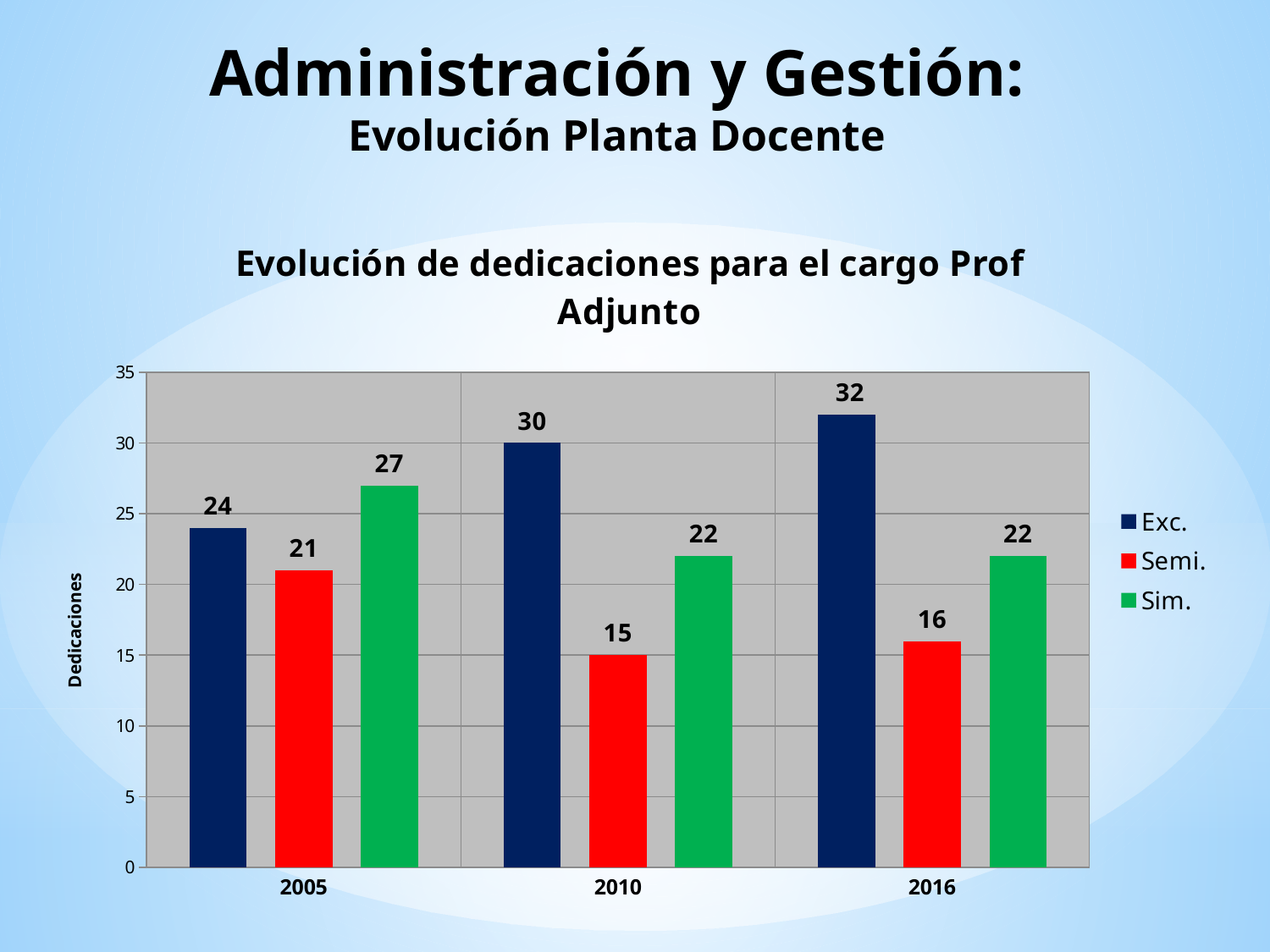
Which is larger in 2005, Exc. or Sim.? Sim. In which year is the Exc. value highest? 2016 What is the label of the vertical axis? Dedicaciones What is the difference between the Exc. value in 2016 and the Exc. value in 2005? 8 What is the value for Semi. in 2010? 15 What is the value for Exc. in 2005? 24 How many years are shown on the x axis? 3 How many series does the legend list? 3 In which year is the Semi. value lowest? 2010 What kind of chart is shown? bar chart Does the Exc. value rise or fall from 2005 to 2016? rise What is the value for Sim. in 2016? 22